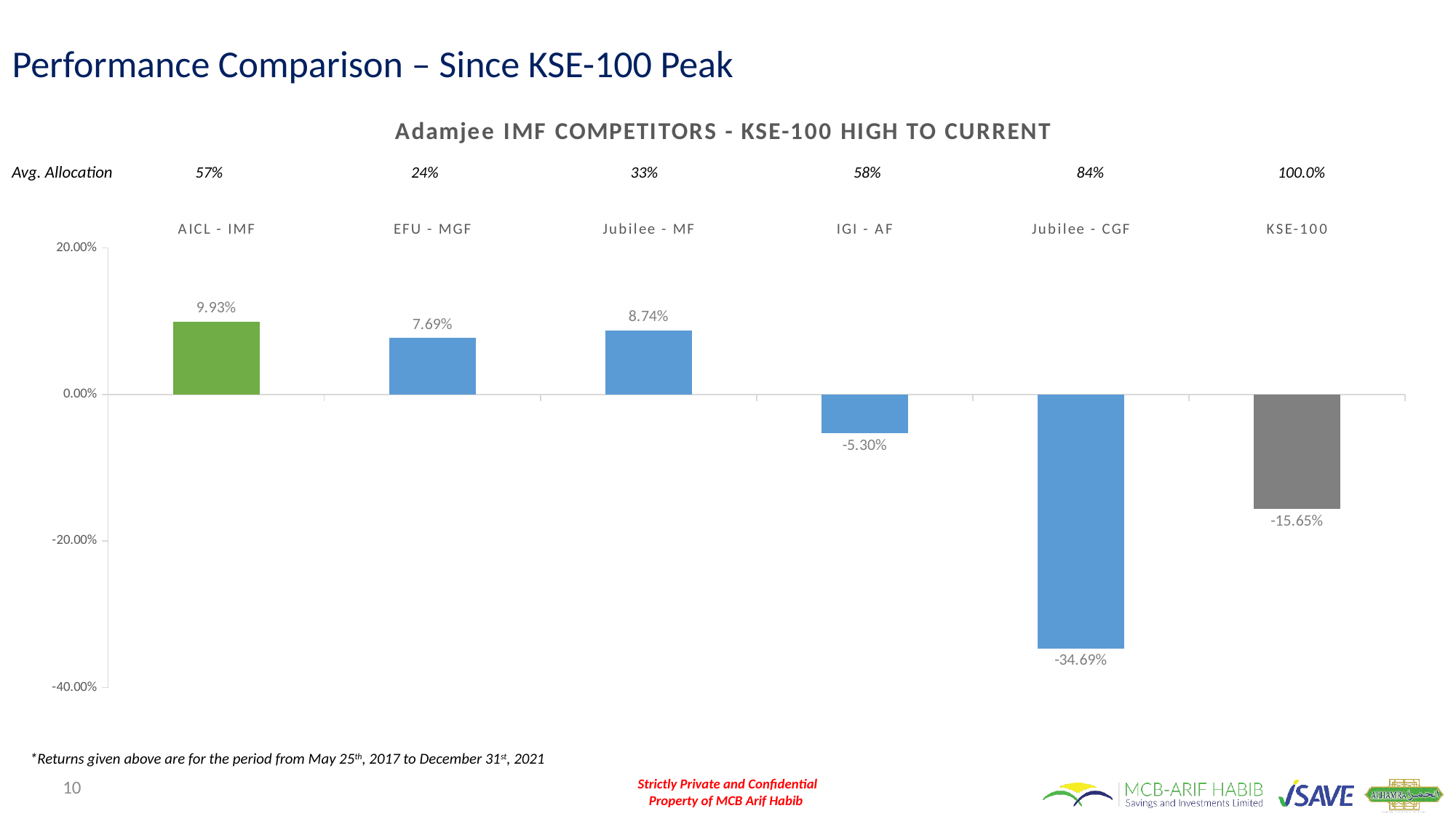
What is the value for Jubilee - CGF? -34.69% Which category has the lowest value? Jubilee - CGF What is the value for KSE-100? -15.65% Which is larger, the value for Jubilee - MF or the value for EFU - MGF? Jubilee - MF What is the difference between the values for AICL - IMF and EFU - MGF? 2.24% What is the title of the chart? Adamjee IMF COMPETITORS - KSE-100 HIGH TO CURRENT What is the value for IGI - AF? -5.30% What is the value for AICL - IMF? 9.93% What kind of chart is shown on the slide? bar chart How many categories are shown in the chart? 6 Which category has the highest value? AICL - IMF Is the value for Jubilee - CGF greater or less than -20.00%? less